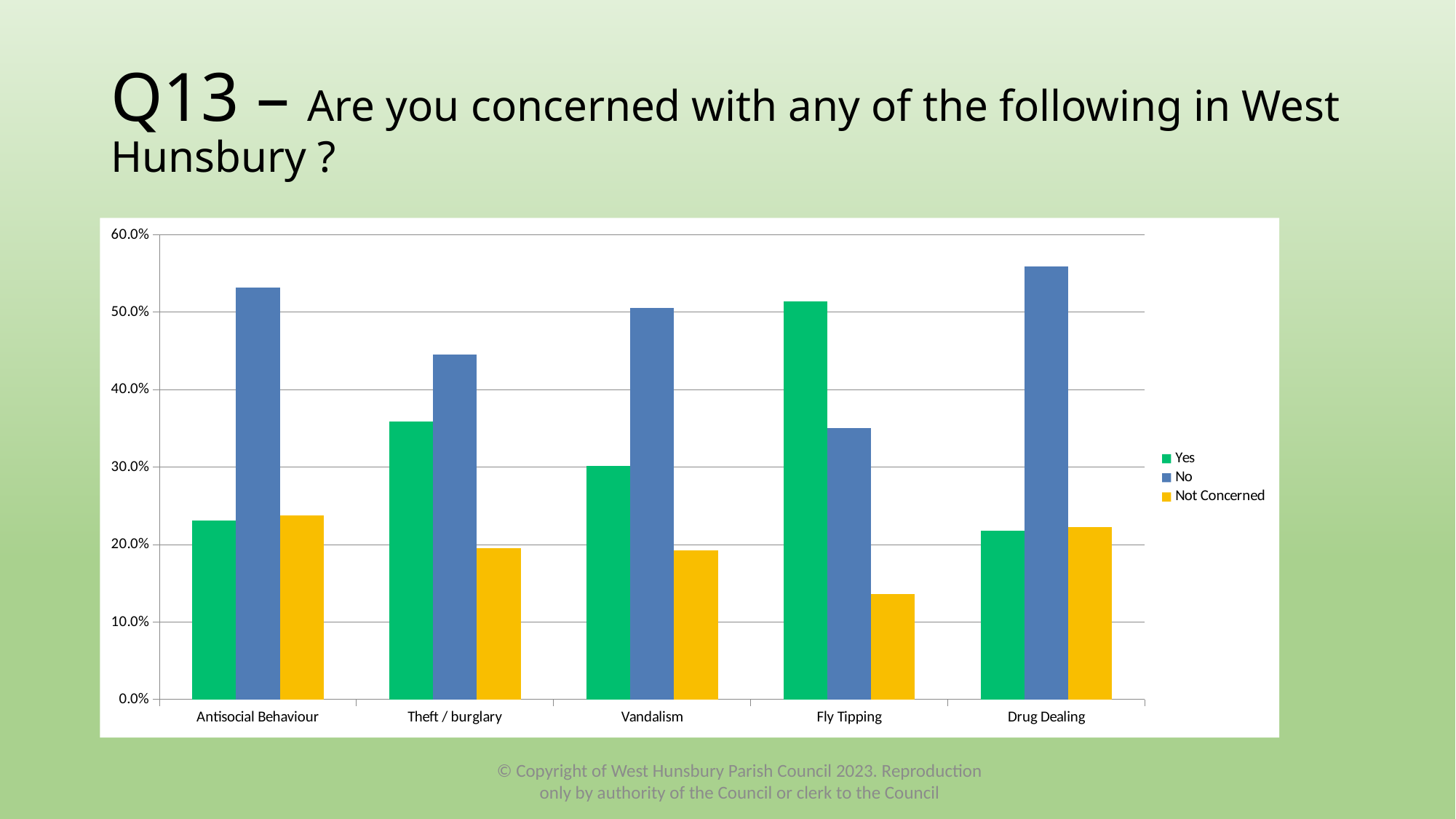
Is the 'No' value for Drug Dealing greater or less than 50.0%? greater For Fly Tipping, which is larger: the 'Yes' value or the 'No' value? Yes Which category has the highest 'Yes' value? Fly Tipping How many categories are shown on the x axis of the chart? 5 Which category has the highest 'No' value? Drug Dealing Is the 'Not Concerned' value for Fly Tipping greater or less than 20.0%? less What kind of chart is shown on the slide? bar chart Is the 'Yes' value for Theft / burglary greater or less than 30.0%? greater How many series does the chart's legend list? 3 Which colour represents the 'Not Concerned' series in the chart? yellow Which category has the lowest 'Not Concerned' value? Fly Tipping